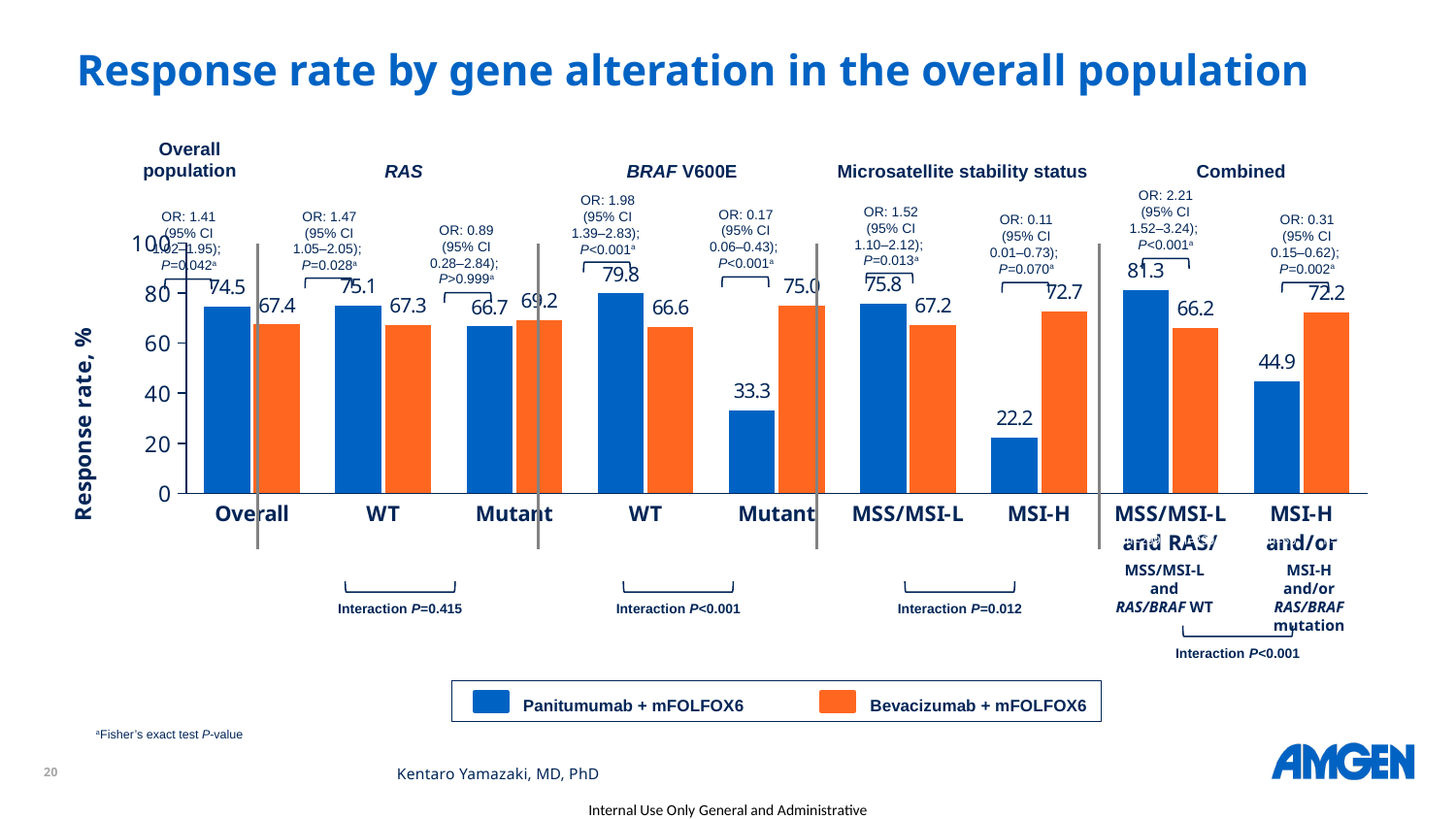
What is the response rate for Bevacizumab + mFOLFOX6 in the BRAF V600E Mutant category? 75.0 Is the Panitumumab + mFOLFOX6 response rate in the BRAF V600E Mutant category greater or less than 40? less What is the label of the y axis? Response rate, % Which category has the lowest response rate for Panitumumab + mFOLFOX6? MSI-H Which category has the highest response rate for Panitumumab + mFOLFOX6? MSS/MSI-L and RAS/BRAF WT What is the difference between the Panitumumab + mFOLFOX6 and Bevacizumab + mFOLFOX6 response rates in the BRAF V600E WT category? 13.2 What is the response rate for Panitumumab + mFOLFOX6 in the MSI-H category under Microsatellite stability status? 22.2 What kind of chart is shown on the slide? Bar chart What is the response rate for Bevacizumab + mFOLFOX6 in the RAS Mutant category? 69.2 In the MSS/MSI-L category, which treatment has the higher response rate? Panitumumab + mFOLFOX6 How many series does the legend list? 2 What is the response rate for Panitumumab + mFOLFOX6 in the Overall category? 74.5